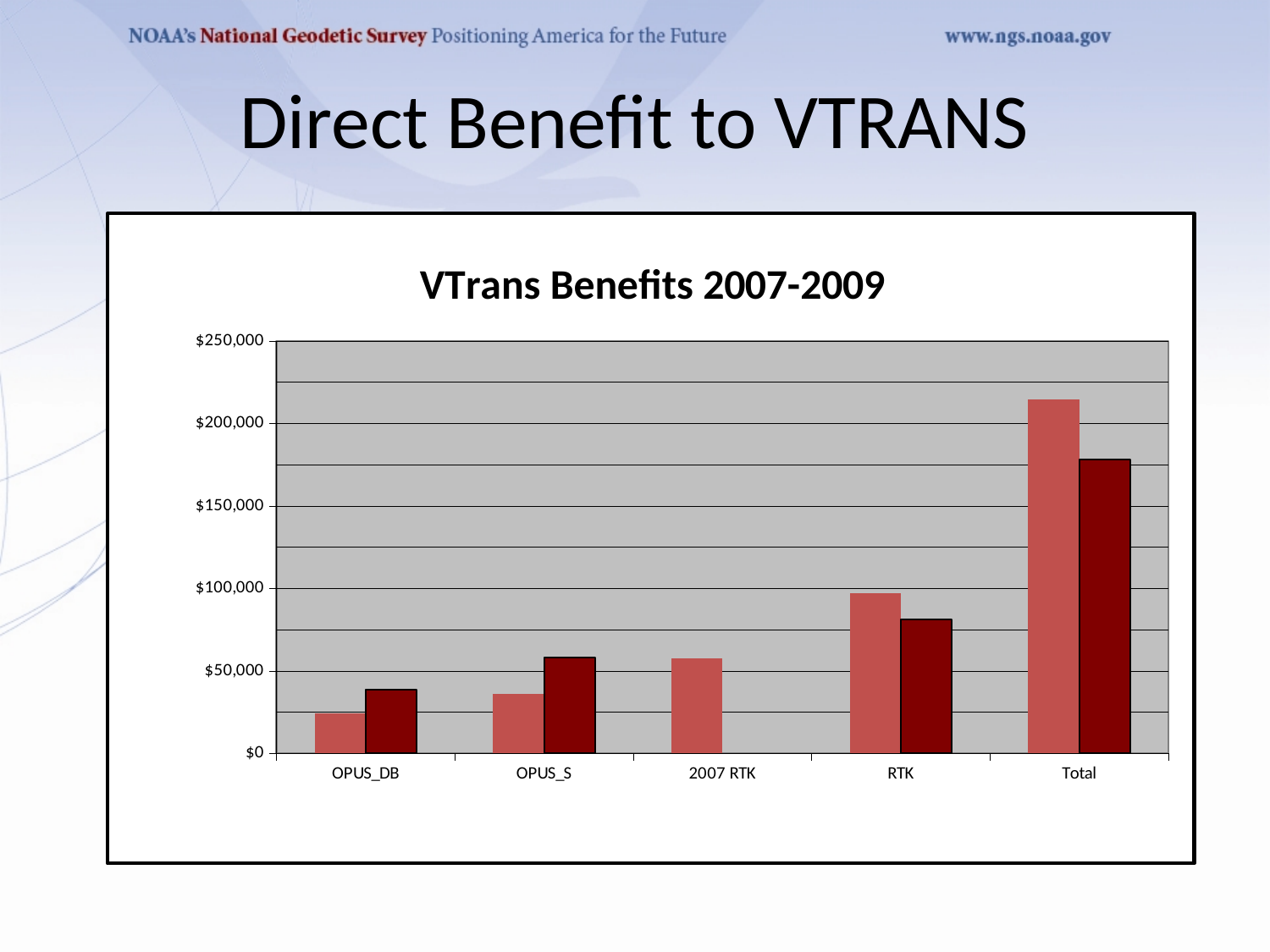
Which category has the highest bars in the chart? Total For OPUS_DB, which bar is taller, the lighter red bar or the dark red bar? the dark red bar Which category has a larger lighter red bar, RTK or Total? Total Which category has the lowest bar in the chart? OPUS_DB Is the value of the lighter red bar for RTK greater or less than $150,000? less Is the value of the taller (lighter red) bar for Total greater or less than $200,000? greater Is the value of the lighter red bar for OPUS_DB greater or less than $50,000? less What kind of chart is shown on the slide? bar chart How many categories are shown on the x axis of the chart? 5 What is the title of the chart? VTrans Benefits 2007-2009